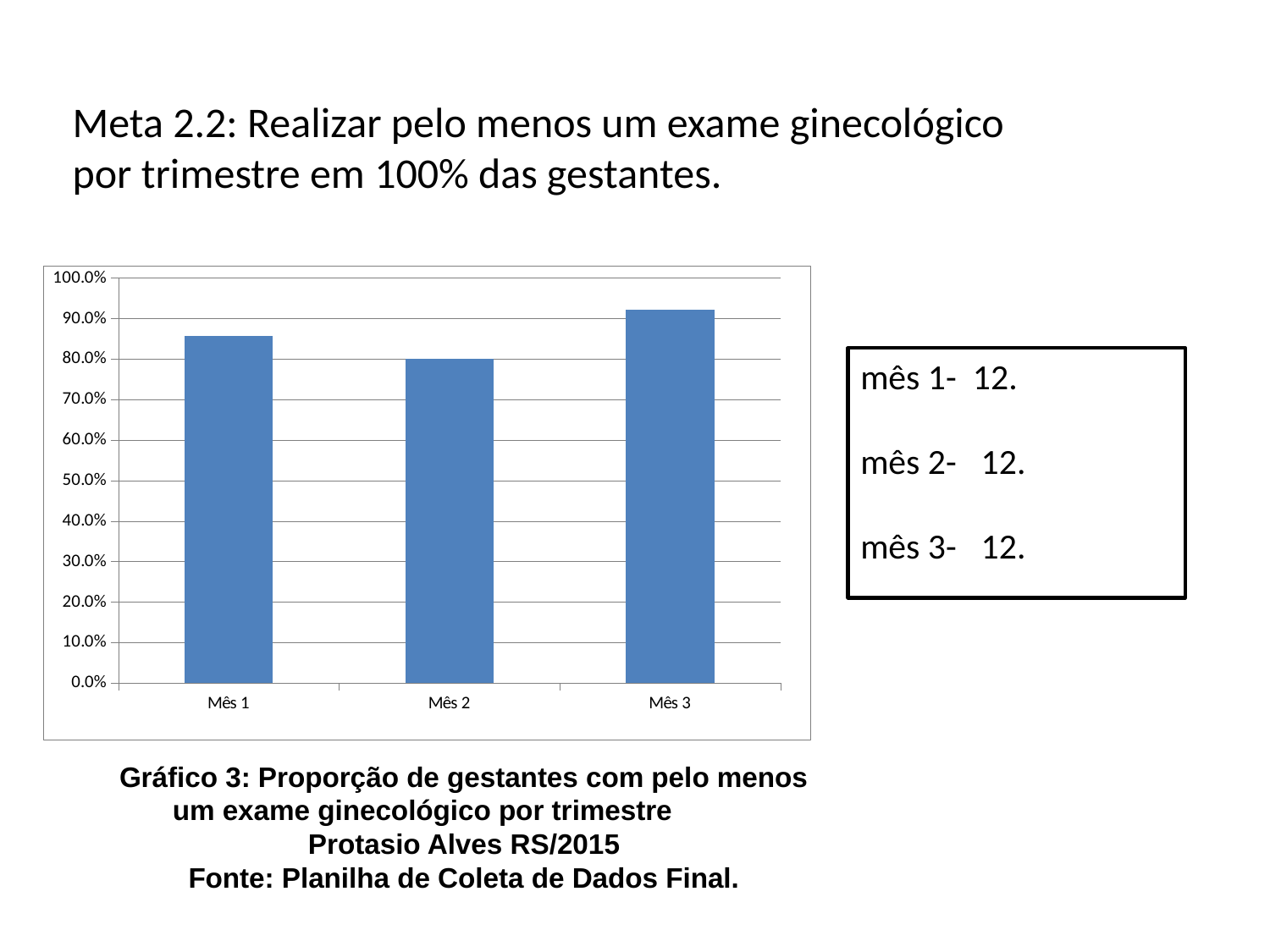
Which month has the highest bar on the chart? Mês 3 Is the value for Mês 1 greater or less than 90.0%? less Which is larger, the value for Mês 1 or the value for Mês 3? Mês 3 Do the values rise or fall from Mês 2 to Mês 3? rise Is the value for Mês 1 greater or less than 80.0%? greater Is the value for Mês 3 greater or less than 90.0%? greater What colour are the bars in the chart? blue What kind of chart is shown on the slide? bar chart How many categories (months) are plotted on the chart? 3 Which is larger, the value for Mês 1 or the value for Mês 2? Mês 1 Which month has the lowest bar on the chart? Mês 2